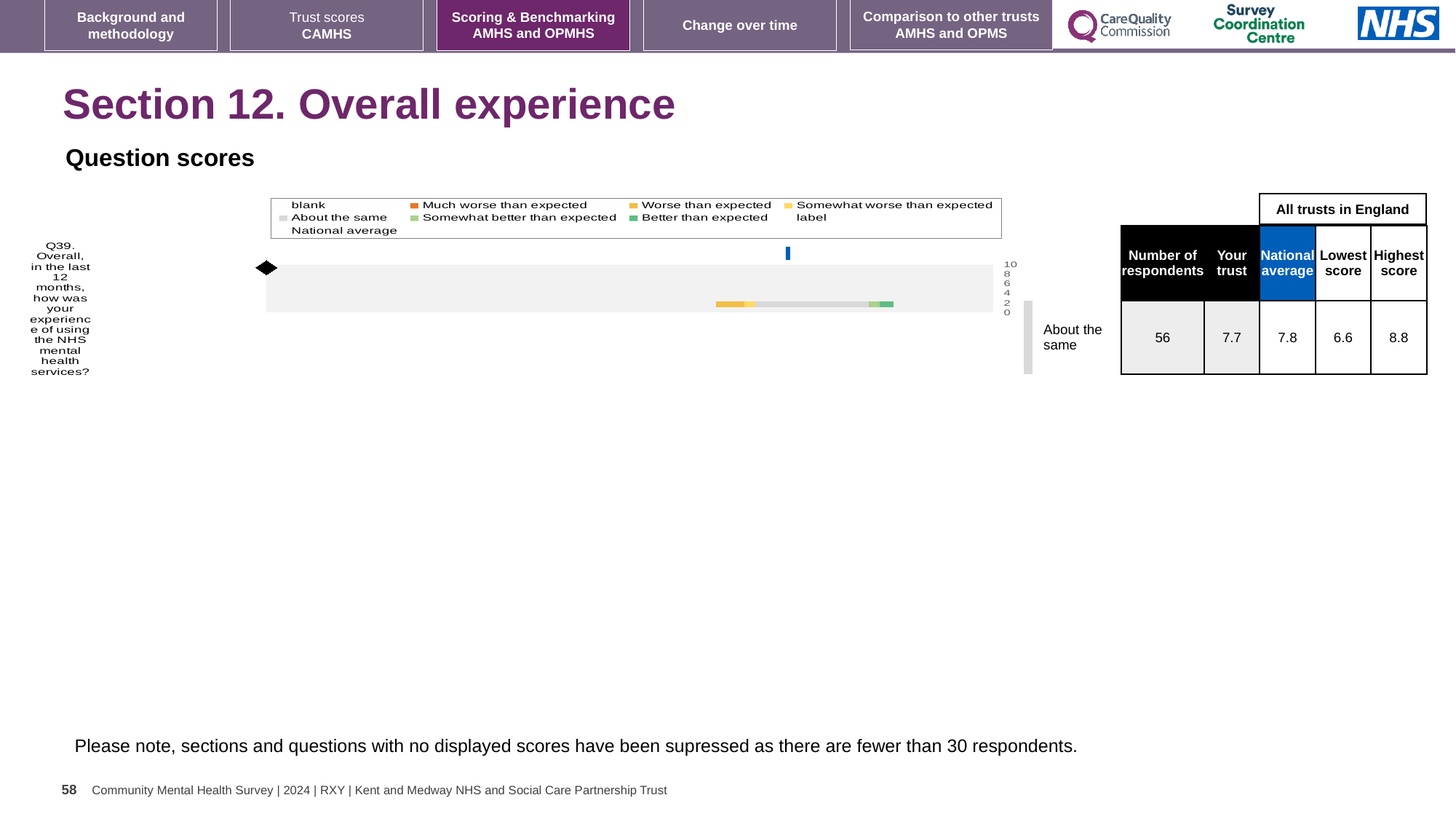
What kind of chart is shown on the slide for Q39? bar chart Which benchmark category is the trust's Q39 score placed in, according to the label beside the chart? About the same What is the difference between the highest score and the lowest score for Q39? 2.2 How many questions are plotted in the chart on the slide? 1 What is the difference between the national average and the 'Your trust' score for Q39? 0.1 What is the highest score among all trusts in England for Q39? 8.8 What is the national average score for Q39 shown on the slide? 7.8 Which is larger for Q39, the 'Your trust' score or the national average? National average How many respondents answered Q39? 56 What is the 'Your trust' score for Q39 shown on the slide? 7.7 What is the lowest score among all trusts in England for Q39? 6.6 What is the maximum value shown on the chart's score axis? 10